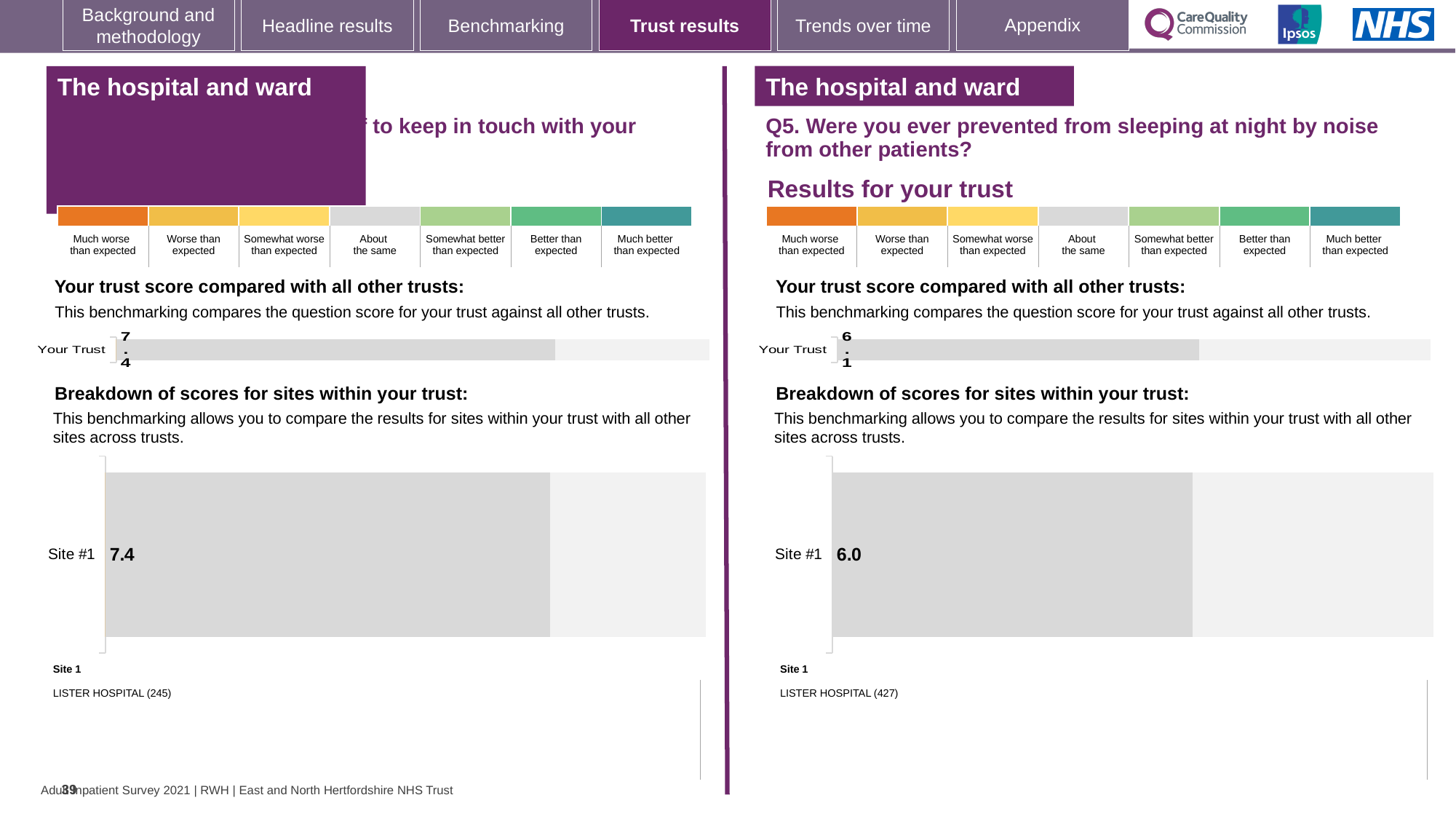
What is the difference between the Site #1 score on the left half of the slide (7.4) and the Site #1 score for Q5 on the right half (6.0)? 1.4 For Q5 on the right half of the slide, what is the difference between the 'Your Trust' score and the Site #1 score? 0.1 On the right half of the slide (Q5), what score is shown for Site #1 in the breakdown of scores for sites chart? 6.0 How many sites are shown in the breakdown of scores chart on the right half of the slide (Q5)? 1 Which is larger: the 'Your Trust' score on the left half of the slide or the 'Your Trust' score for Q5 on the right half? The left half (7.4) On the left half of the slide, what is the score shown for 'Your Trust' in the trust score chart? 7.4 What type of chart is used to show the Site #1 score on the left half of the slide? Bar chart On the right half of the slide (Q5, prevented from sleeping at night by noise from other patients), what is the score shown for 'Your Trust'? 6.1 Is the Site #1 score on the left half of the slide greater or less than the Site #1 score for Q5 on the right half? greater How many categories does the colour scale above the trust score chart on the right half of the slide show, from 'Much worse than expected' to 'Much better than expected'? 7 On the left half of the slide, what score is shown for Site #1 in the breakdown of scores for sites chart? 7.4 Which hospital is listed as Site 1 on the right half of the slide (Q5)? LISTER HOSPITAL (427)